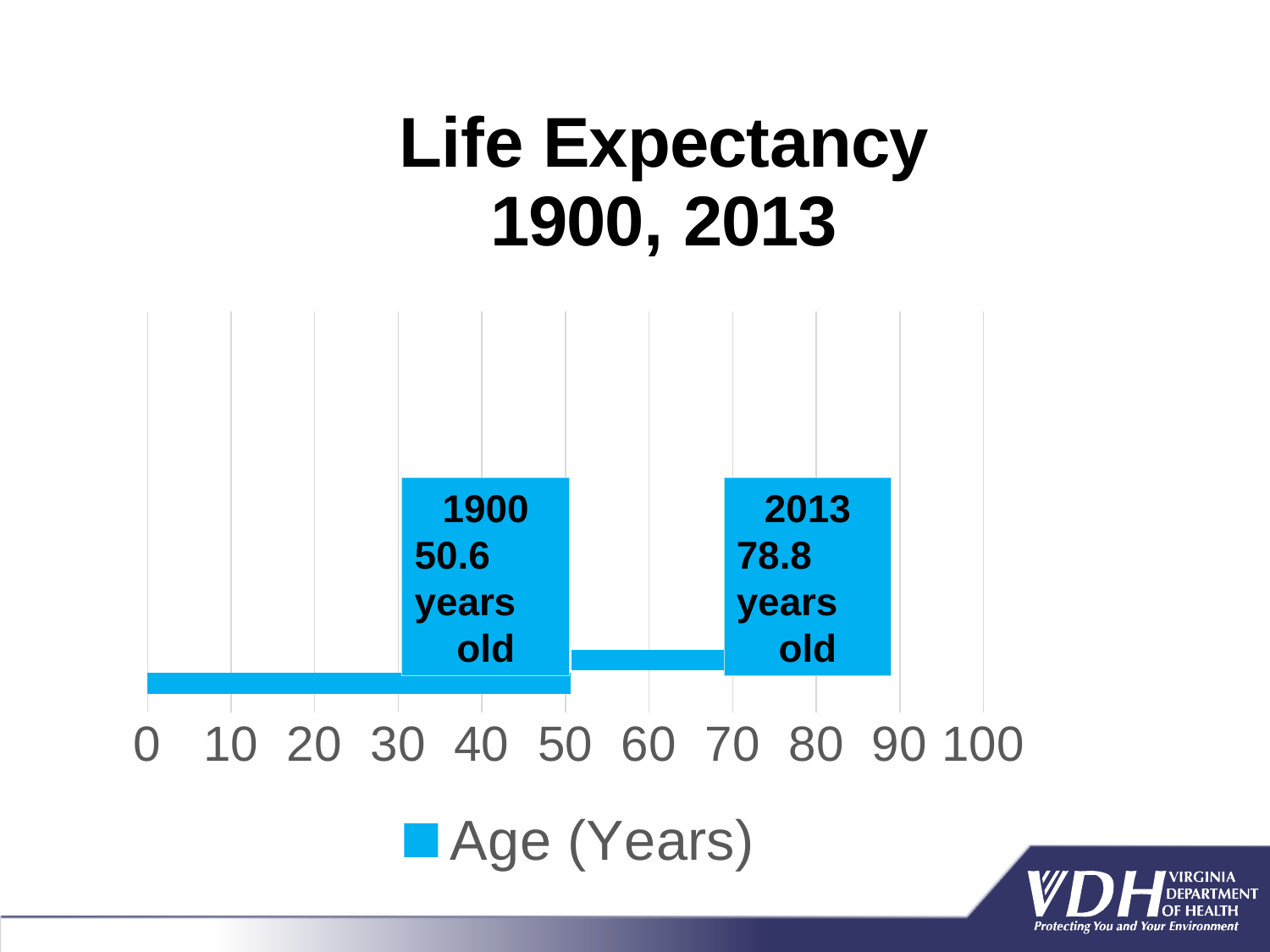
Which year has the lowest life expectancy on the chart? 1900 How many years (categories) are plotted on the chart? 2 What is the life expectancy shown for 2013? 78.8 years old By how many years did life expectancy increase from 1900 to 2013? 28.2 years What is the life expectancy shown for 1900? 50.6 years old What type of chart is shown on the slide? Bar chart Is the life expectancy for 1900 greater or less than 60? less What is the legend entry shown below the chart? Age (Years) Is the life expectancy for 2013 greater or less than 70? greater What is the title of the chart on the slide? Life Expectancy 1900, 2013 Which year has the higher life expectancy, 1900 or 2013? 2013 How many series does the legend list? 1